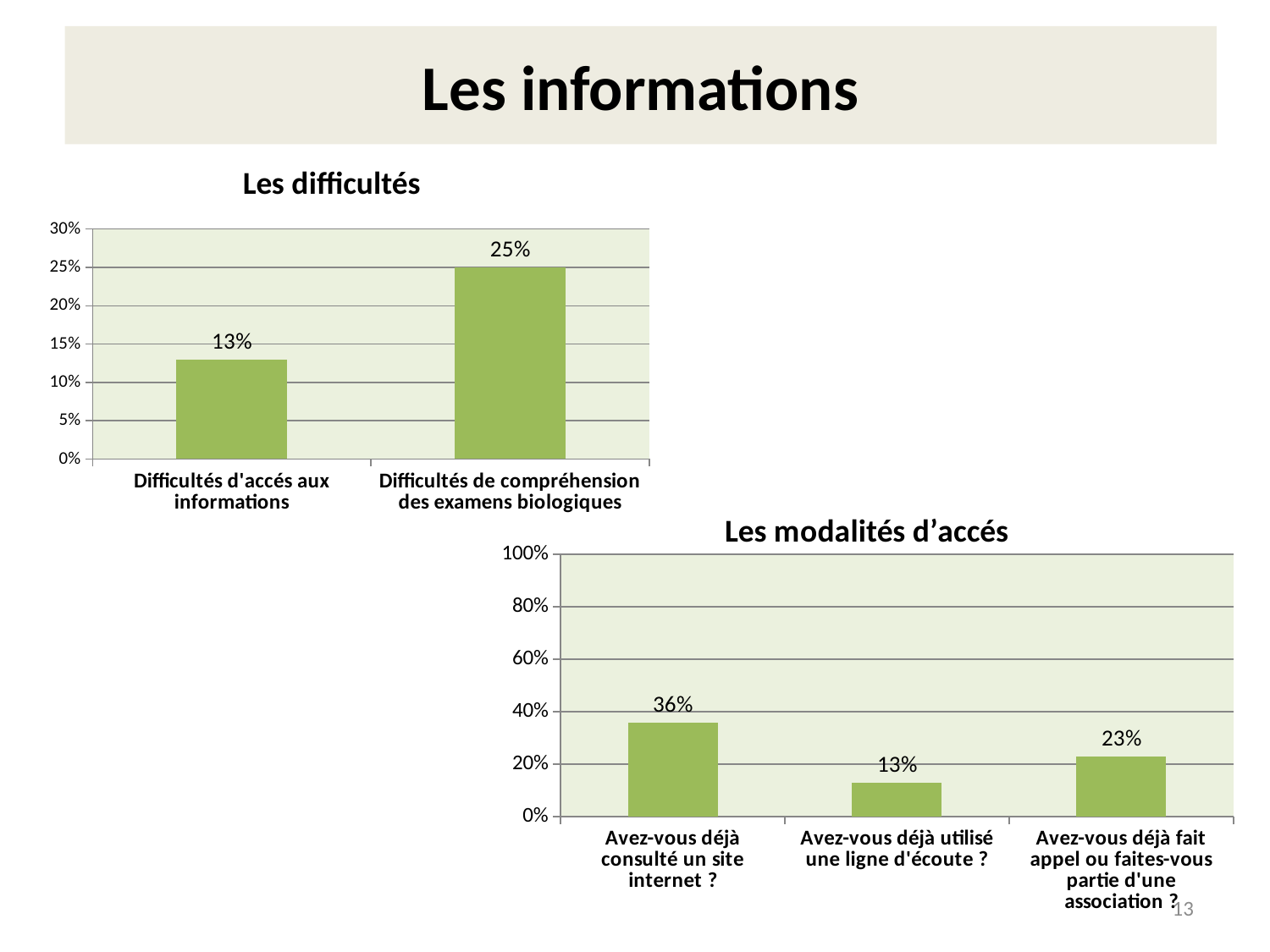
In the 'Les modalités d'accés' chart, what is the value for 'Avez-vous déjà fait appel ou faites-vous partie d'une association ?'? 23% In the 'Les difficultés' chart, what is the difference between the two bars? 12% In the 'Les difficultés' chart, what is the value for 'Difficultés d'accés aux informations'? 13% In the 'Les modalités d'accés' chart, what is the difference between 'Avez-vous déjà consulté un site internet ?' and 'Avez-vous déjà fait appel ou faites-vous partie d'une association ?'? 13% In the 'Les modalités d'accés' chart, what is the value for 'Avez-vous déjà utilisé une ligne d'écoute ?'? 13% In the 'Les difficultés' chart, which category has the highest value? Difficultés de compréhension des examens biologiques In the 'Les modalités d'accés' chart, how many categories are shown? 3 What type of chart is 'Les modalités d'accés'? Bar chart In the 'Les modalités d'accés' chart, what is the value for 'Avez-vous déjà consulté un site internet ?'? 36% In the 'Les modalités d'accés' chart, which category has the lowest value? Avez-vous déjà utilisé une ligne d'écoute ? In the 'Les difficultés' chart, what is the value for 'Difficultés de compréhension des examens biologiques'? 25% In the 'Les difficultés' chart, how many categories are shown? 2